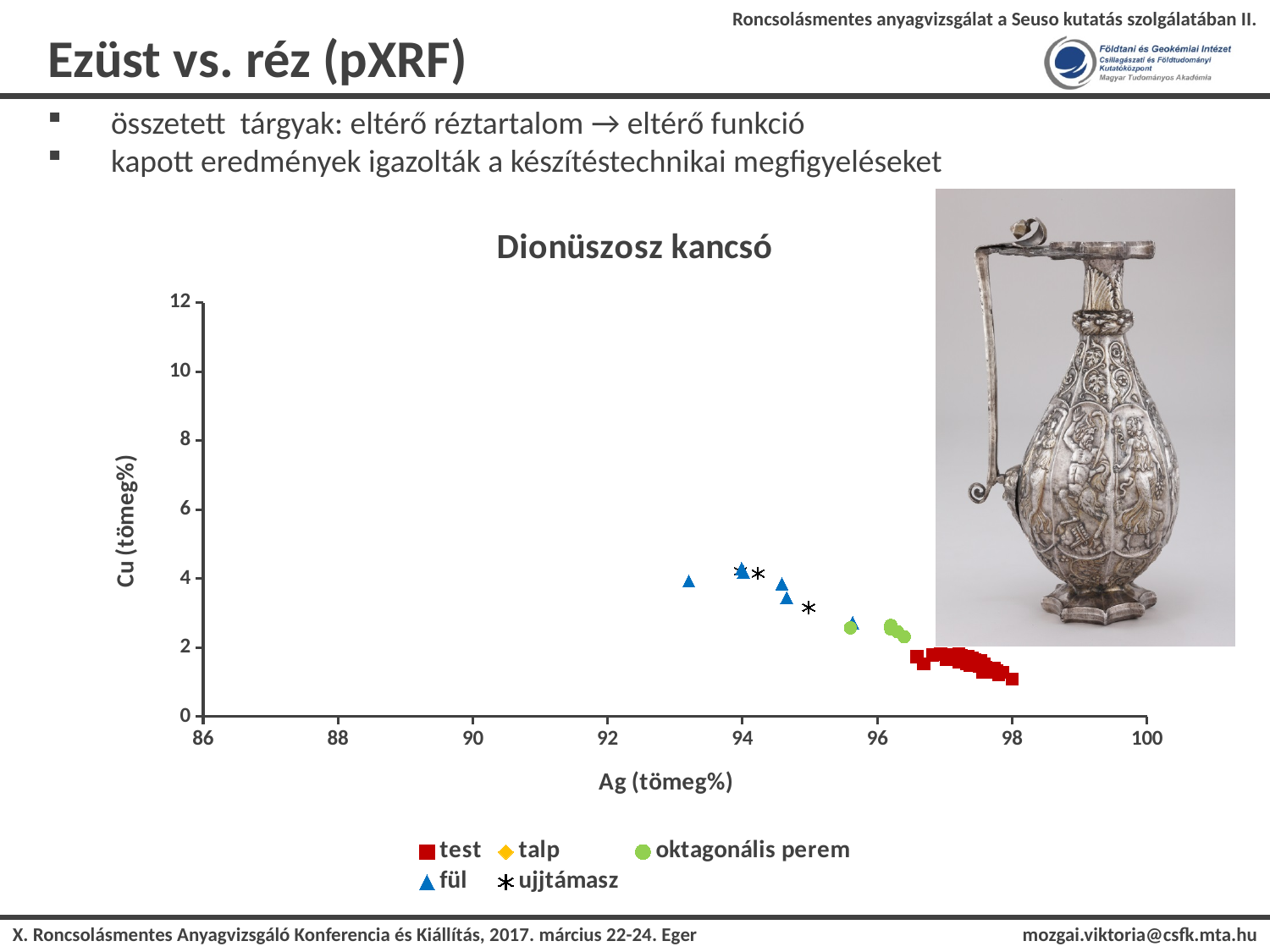
Which series has the highest Ag (tömeg%) values in the chart? test What is the title of the chart? Dionüszosz kancsó Which series has higher Ag (tömeg%) values, oktagonális perem or fül? oktagonális perem Are the Ag (tömeg%) values of the test series greater or less than 96? greater Which series has the lowest Cu (tömeg%) values in the chart? test How many series does the legend of the chart list? 5 What is the label of the y axis of the chart? Cu (tömeg%) What kind of chart is shown on the slide? scatter chart Are the Cu (tömeg%) values of the fül series greater or less than 6? less Which series has higher Cu (tömeg%) values, test or fül? fül Are the Cu (tömeg%) values of the test series greater or less than 2? less Which series has the highest Cu (tömeg%) values in the chart? fül